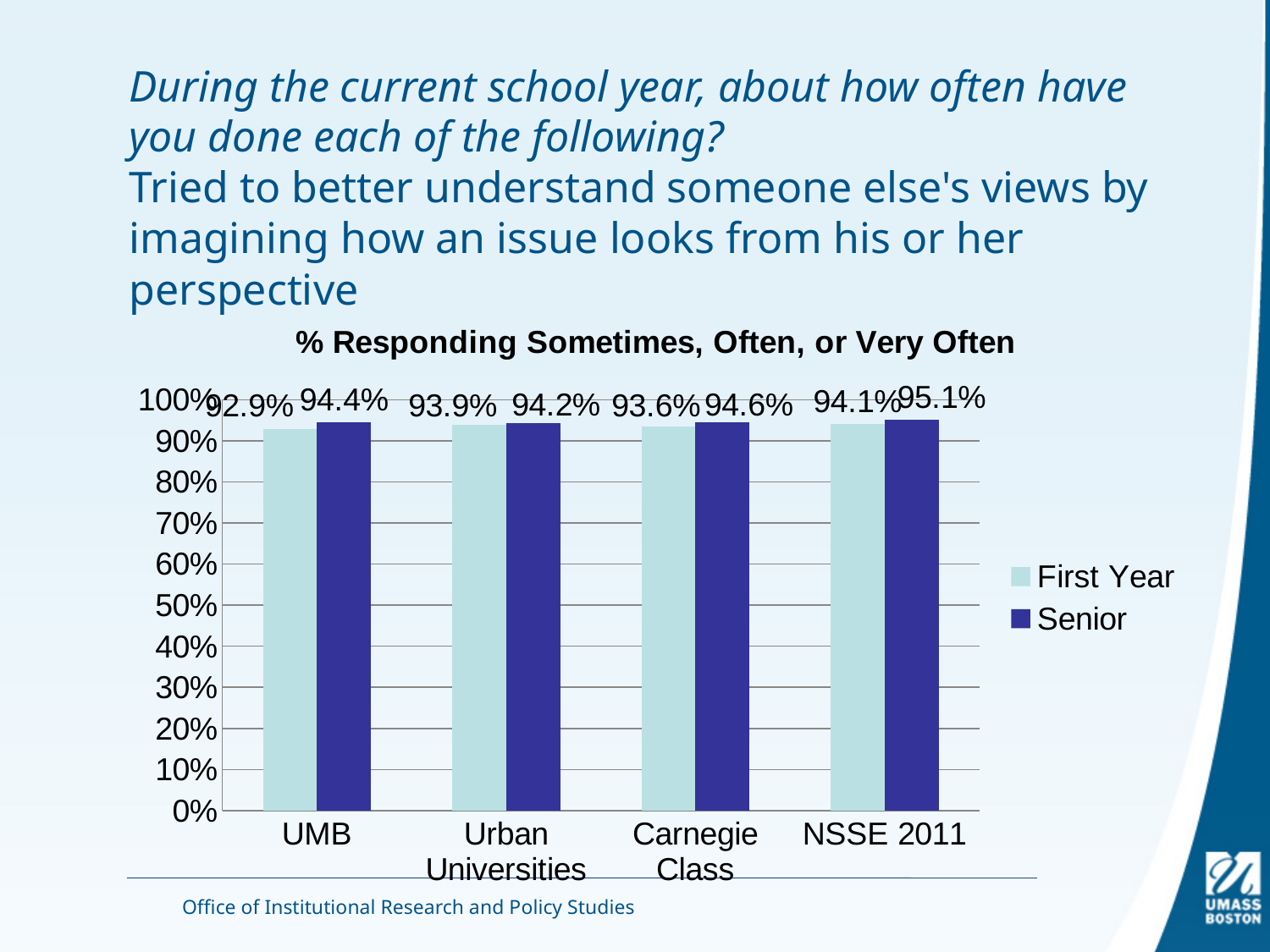
What is the difference between the Senior and First Year values for UMB? 1.5% What is the First Year value for UMB? 92.9% Which category has the lowest First Year value? UMB How many categories are shown on the x axis? 4 What is the title of the chart? % Responding Sometimes, Often, or Very Often Which is larger for Carnegie Class, the First Year value or the Senior value? Senior What is the Senior value for Carnegie Class? 94.6% What is the Senior value for NSSE 2011? 95.1% What kind of chart is shown on the slide? Bar chart Which category has the highest Senior value? NSSE 2011 What is the First Year value for Urban Universities? 93.9% How many series does the legend list? 2